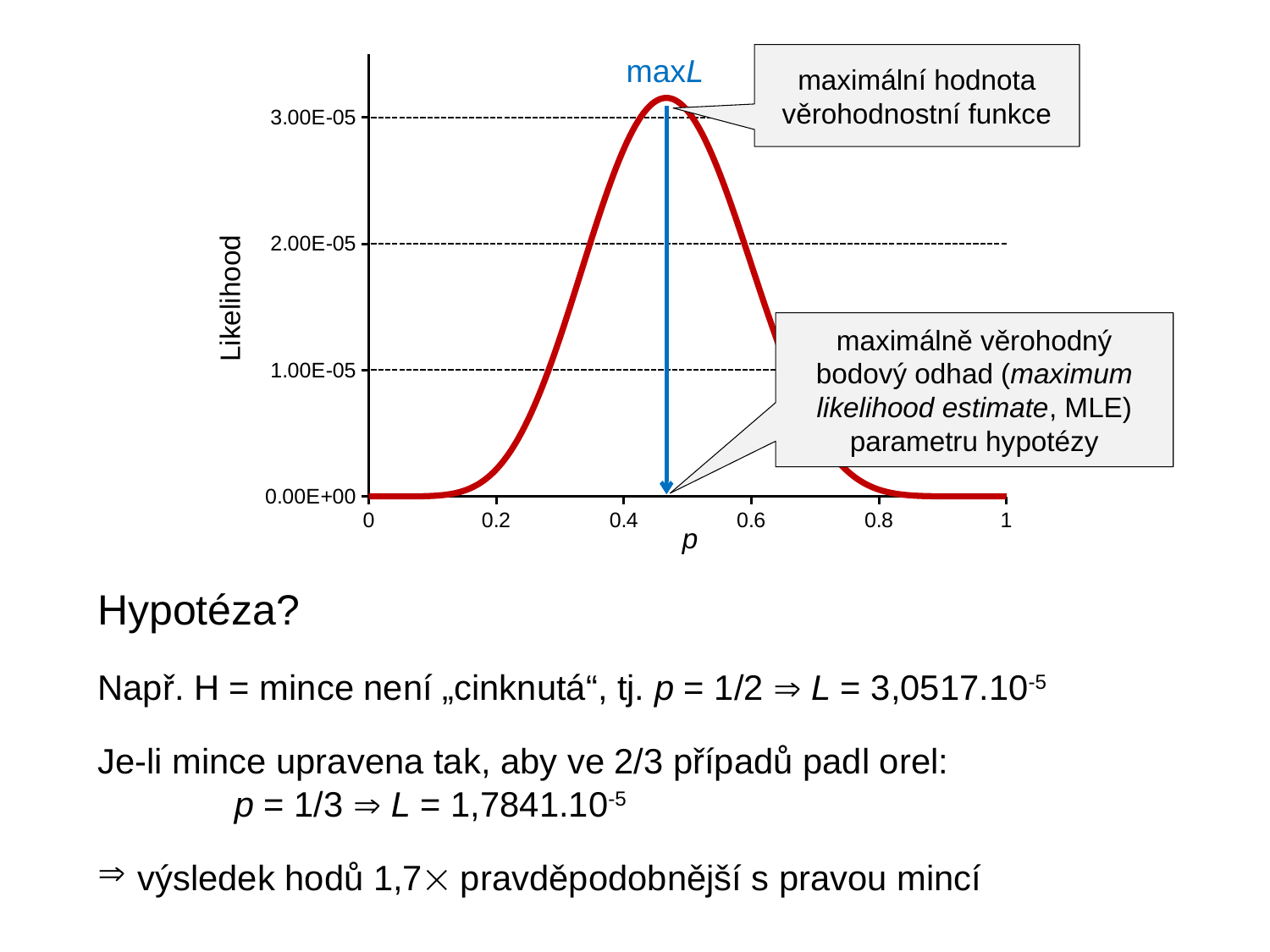
Is the likelihood value at p = 0.4 greater or less than 2.00E-05? greater What is the label of the x axis of the chart? p Between which two x-axis ticks does the peak of the likelihood curve (maxL) lie? 0.4 and 0.6 Which has the higher likelihood value, p = 0.4 or p = 0.6? p = 0.4 What is the label of the y axis of the chart? Likelihood What kind of chart is shown on the slide? line chart Does the likelihood curve rise or fall as p increases from 0 to 0.4? rise Is the maximum of the likelihood curve greater or less than 3.00E-05? greater Does the likelihood curve rise or fall as p increases from 0.6 to 1? fall Is the likelihood value at p = 0.2 greater or less than 1.00E-05? less